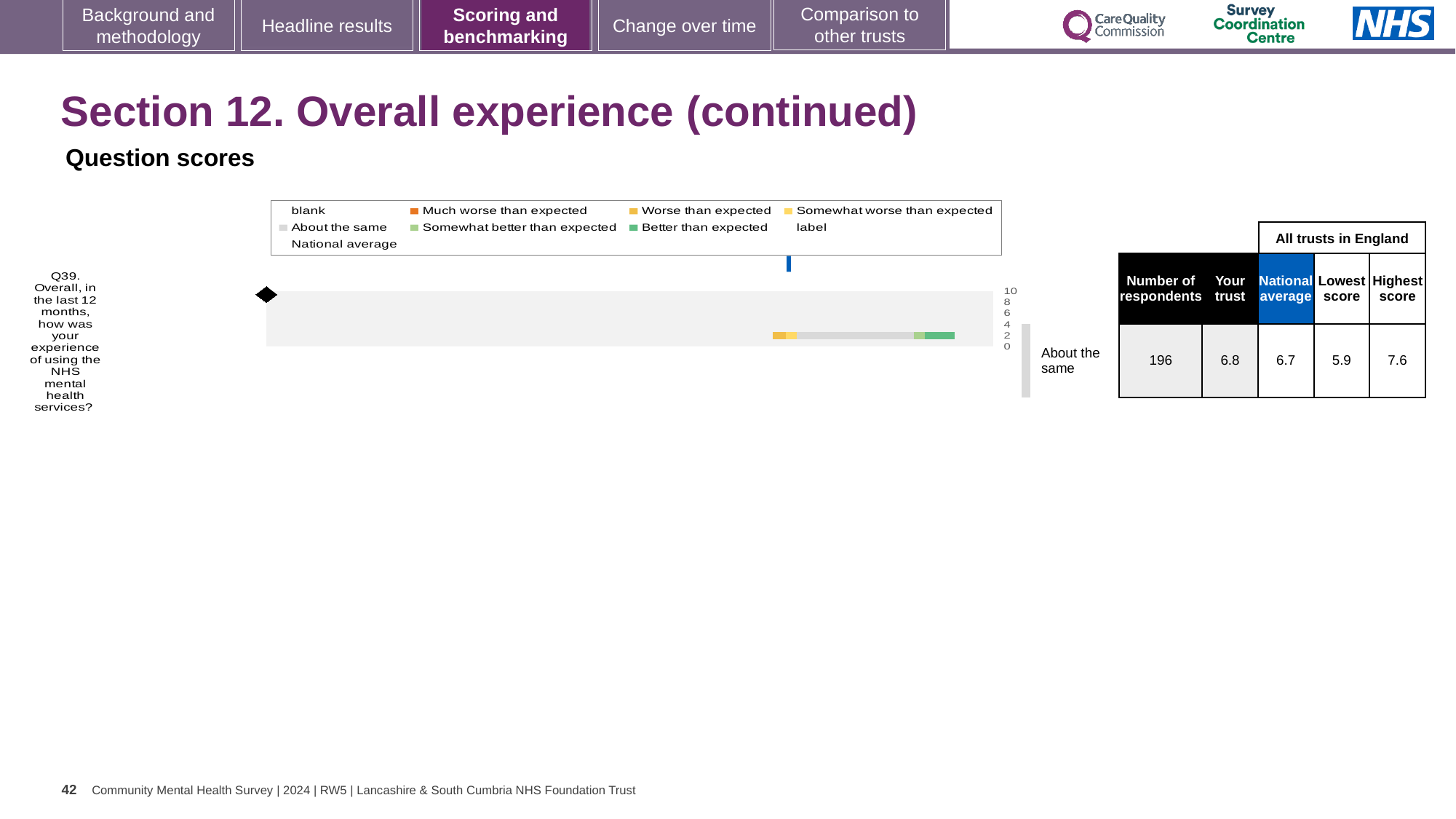
What is the highest score among all trusts in England for Q39? 7.6 What is the difference between the 'Your trust' score and the national average for Q39? 0.1 How many respondents answered Q39? 196 What is the lowest score among all trusts in England for Q39? 5.9 Which benchmark category is the trust's Q39 result placed in? About the same What is the 'Your trust' score for Q39 (Overall, in the last 12 months, how was your experience of using the NHS mental health services?)? 6.8 How many questions are plotted on the chart? 1 What colour does the legend use for 'Better than expected'? Green What kind of chart is used to show the Q39 question score? Bar chart For Q39, which is larger: the 'Your trust' score or the national average? Your trust What is the difference between the highest and lowest trust scores for Q39? 1.7 What is the national average score for Q39? 6.7